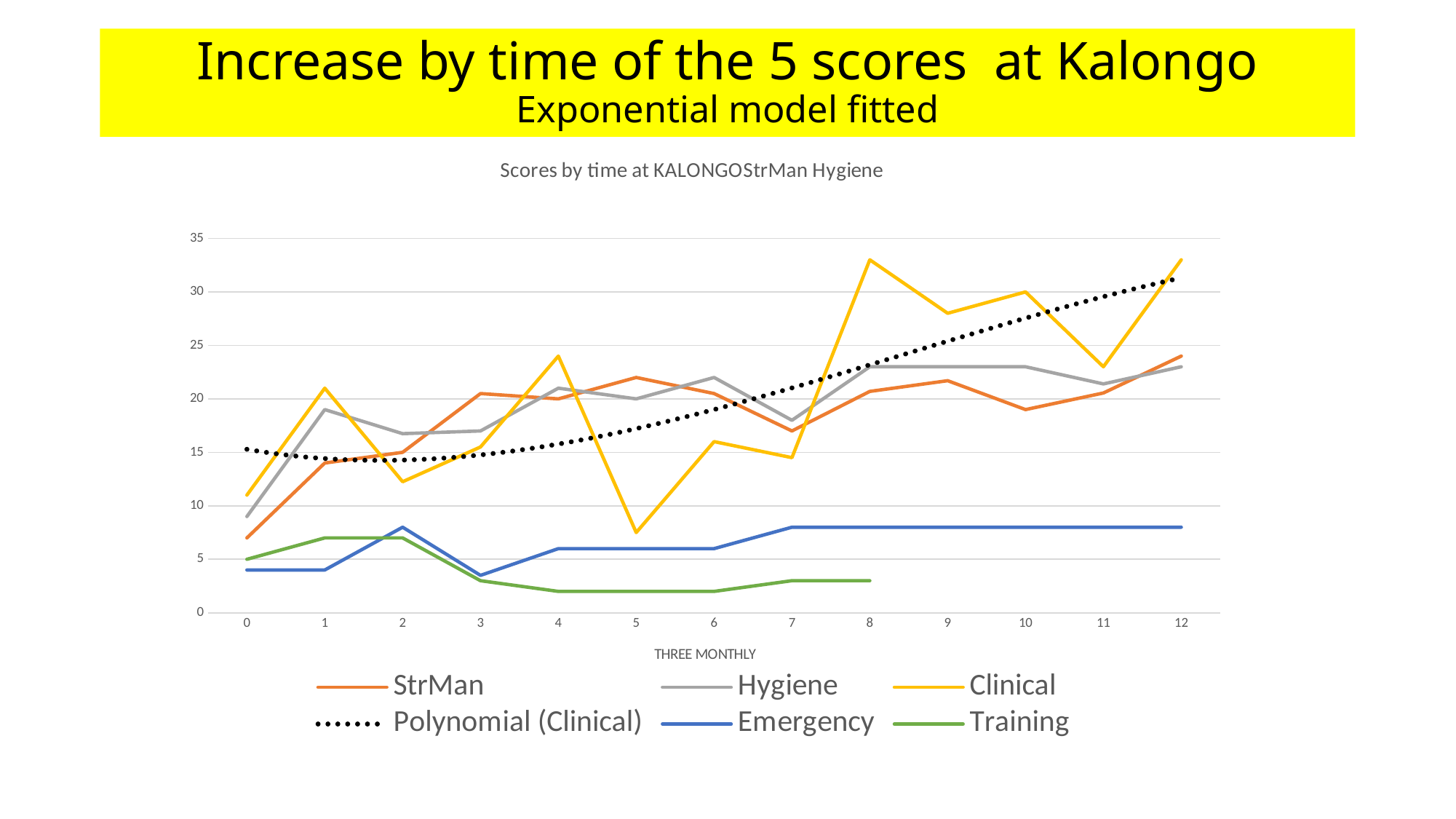
Is the Clinical value at time point 8 greater or less than 30? greater Which series has the highest value at time point 8? Clinical Is the Clinical value at time point 5 greater or less than 10? less At time point 12, which is larger, the Clinical value or the StrMan value? Clinical What kind of chart is shown on the slide? line chart Which series has the lowest value at time point 4? Training At time point 5, which is larger, the StrMan value or the Clinical value? StrMan Is the Training value at time point 4 greater or less than 5? less How many series does the legend list? 6 Does the Emergency series rise or fall overall from time point 0 to time point 12? rise How many time points are shown on the x axis? 13